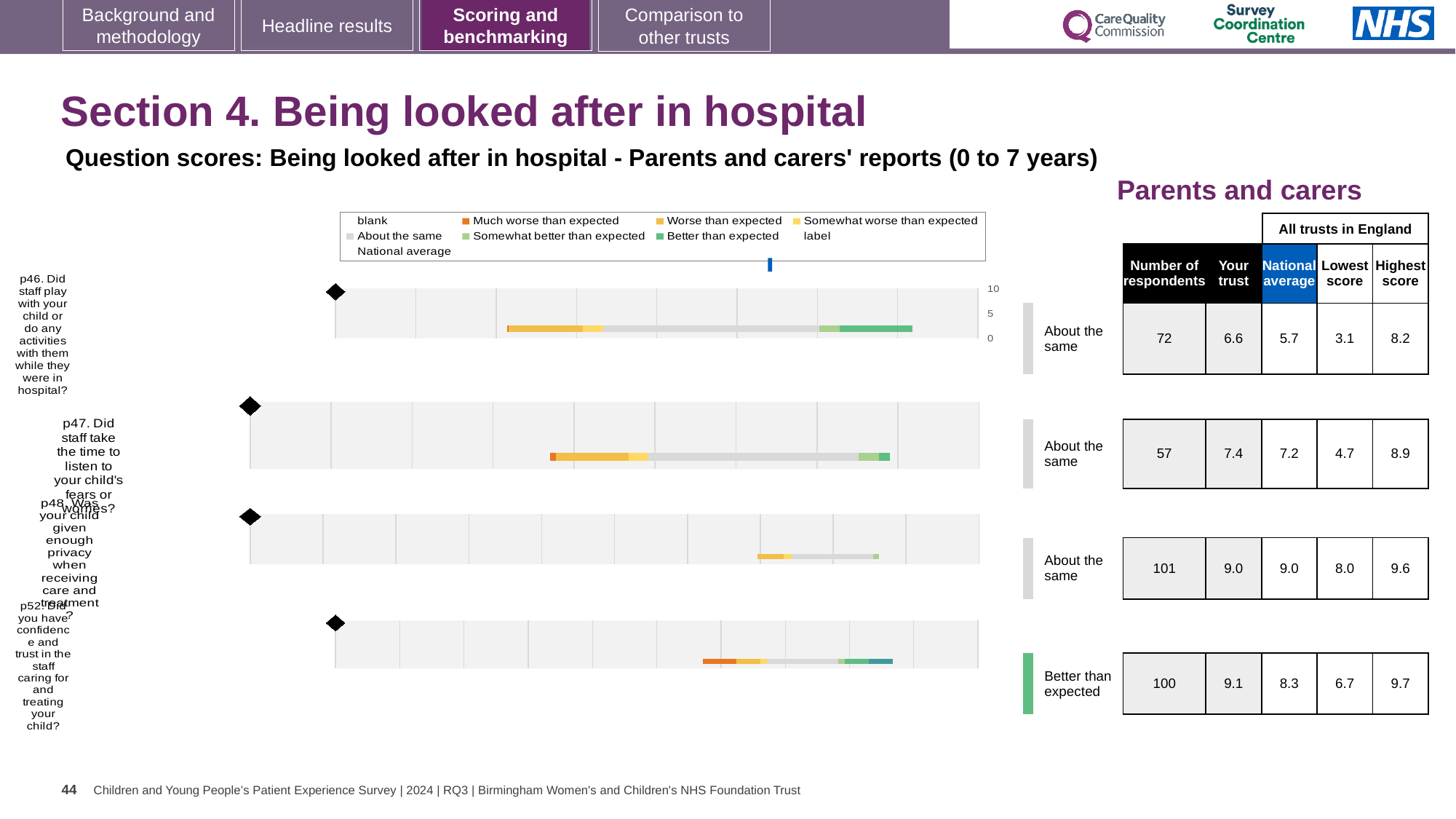
For p52, what is the difference between the 'Your trust' score (9.1) and the national average (8.3)? 0.8 Which question has the highest 'Your trust' score? p52 What is the 'Your trust' score for p46 (Did staff play with your child or do any activities with them while they were in hospital?)? 6.6 What kind of chart is used to show the question scores on this slide? bar chart What is the highest score among all trusts in England for p52? 9.7 How many question charts (p46, p47, p48, p52) are shown on the slide? 4 Which question has the lowest 'Your trust' score? p46 How many respondents answered p48 (Was your child given enough privacy when receiving care and treatment?)? 101 What is the lowest score among all trusts in England for p46? 3.1 What is the national average score for p47 (Did staff take the time to listen to your child's fears or worries?)? 7.2 For p47, which is larger: the 'Your trust' score or the national average? Your trust Which question is rated 'Better than expected' for this trust? p52